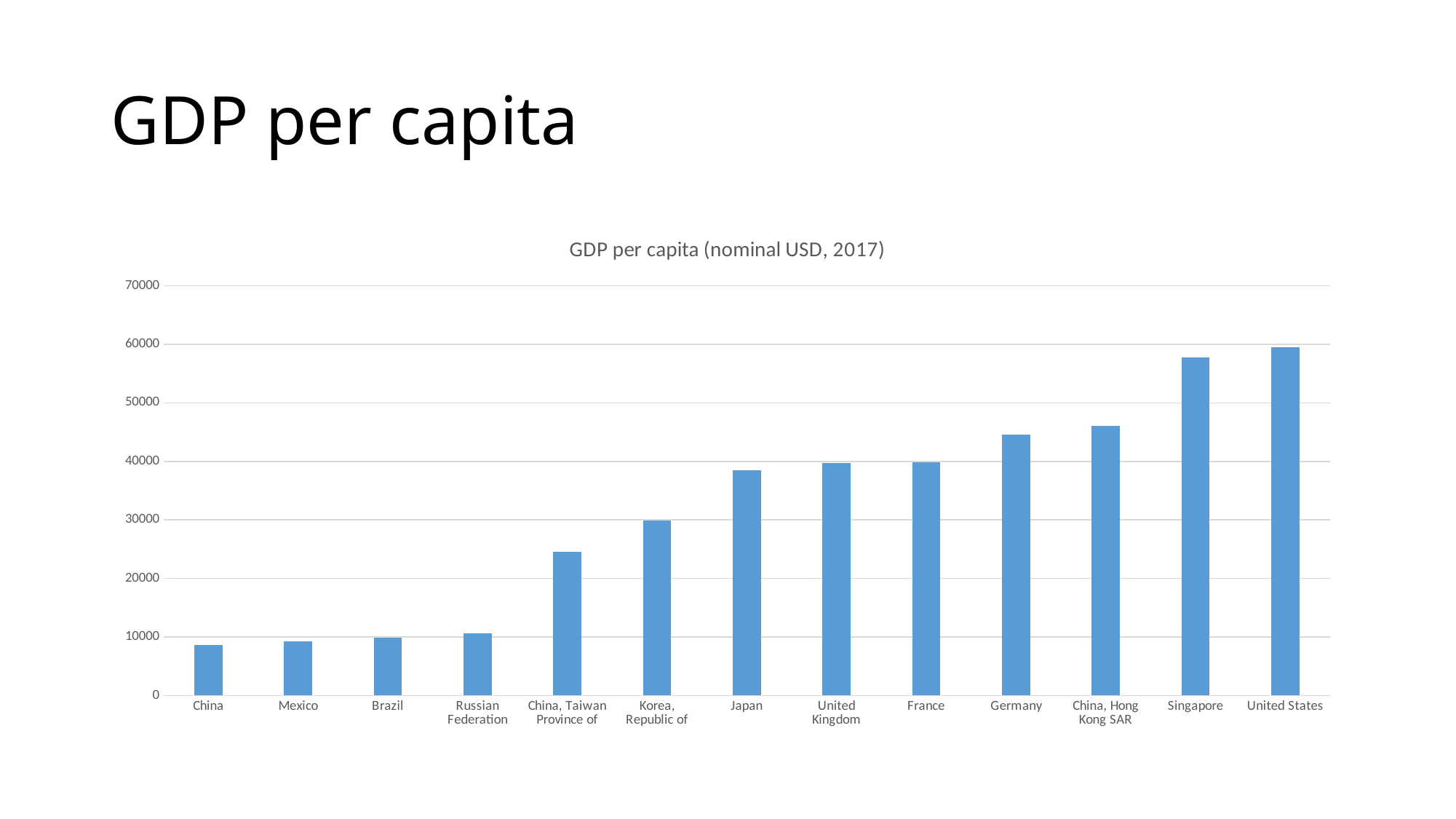
Is the value for Germany greater or less than 40000? greater What kind of chart is shown on the slide? bar chart Is the value for China greater or less than 10000? less Which has a higher GDP per capita, Singapore or Germany? Singapore Do the values rise or fall moving from left to right along the x axis? rise Which country has the lowest GDP per capita in the chart? China How many countries or regions are shown on the x axis of the chart? 13 Which has a higher GDP per capita, Japan or Korea, Republic of? Japan Which country has the highest GDP per capita in the chart? United States Is the value for China, Taiwan Province of greater or less than 20000? greater What is the title of the chart? GDP per capita (nominal USD, 2017)